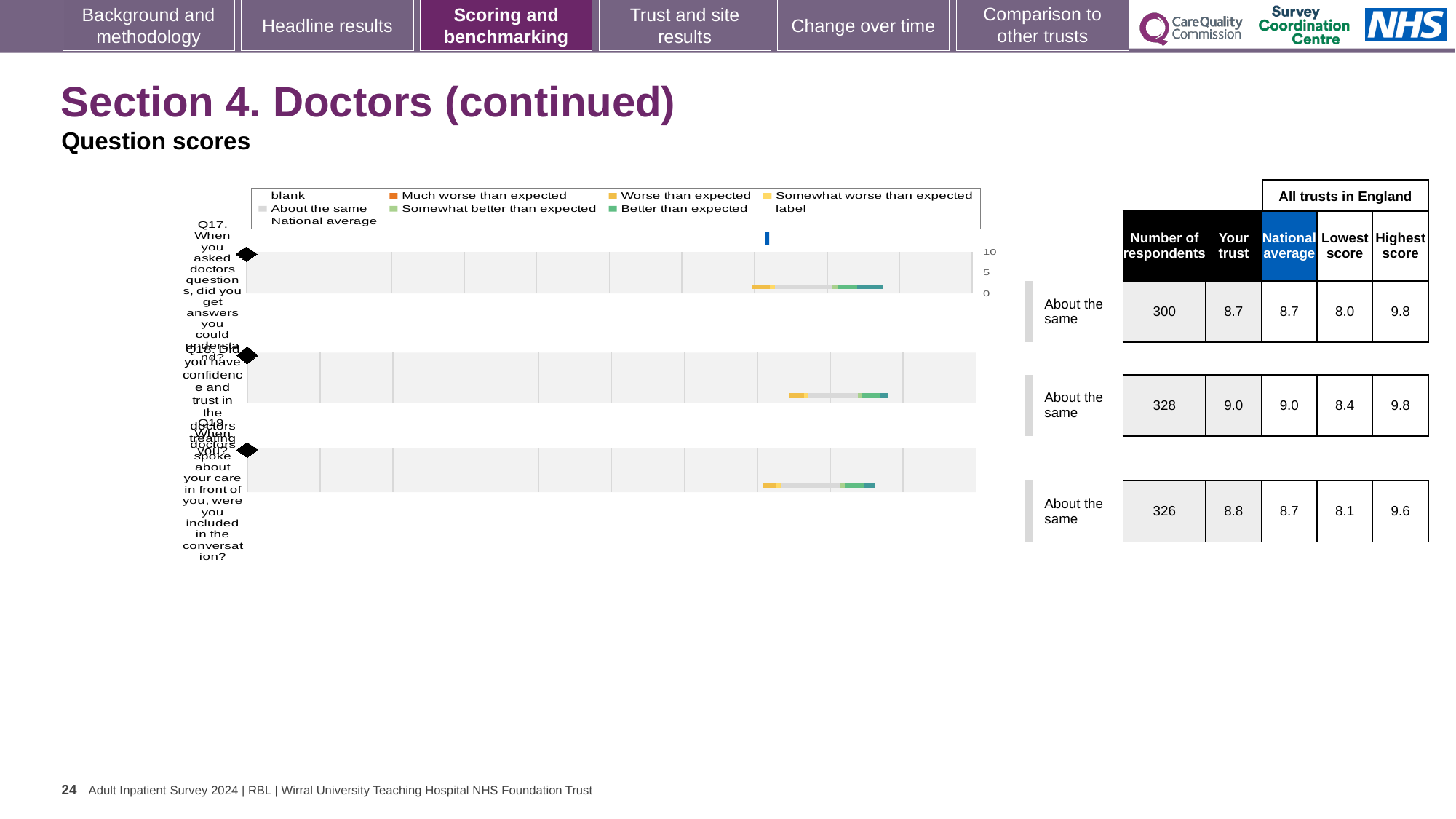
What kind of chart is used to show the question scores on this slide? bar chart How many more respondents answered Q18 than Q17? 28 For Q19, which is larger: the 'Your trust' score or the national average? Your trust Which question has the lowest 'Lowest score' across all trusts in England? Q17 For Q19, what is the difference between the highest score and the lowest score across all trusts in England? 1.5 Which question has the highest 'Your trust' score? Q18 How many questions (Q17, Q18, Q19) are plotted on the slide? 3 What is the national average score for Q18? 9.0 What benchmark category is shown for Q17? About the same What is the highest value shown on the chart's score axis? 10 How many respondents answered Q19? 326 What is the 'Your trust' score for Q17? 8.7